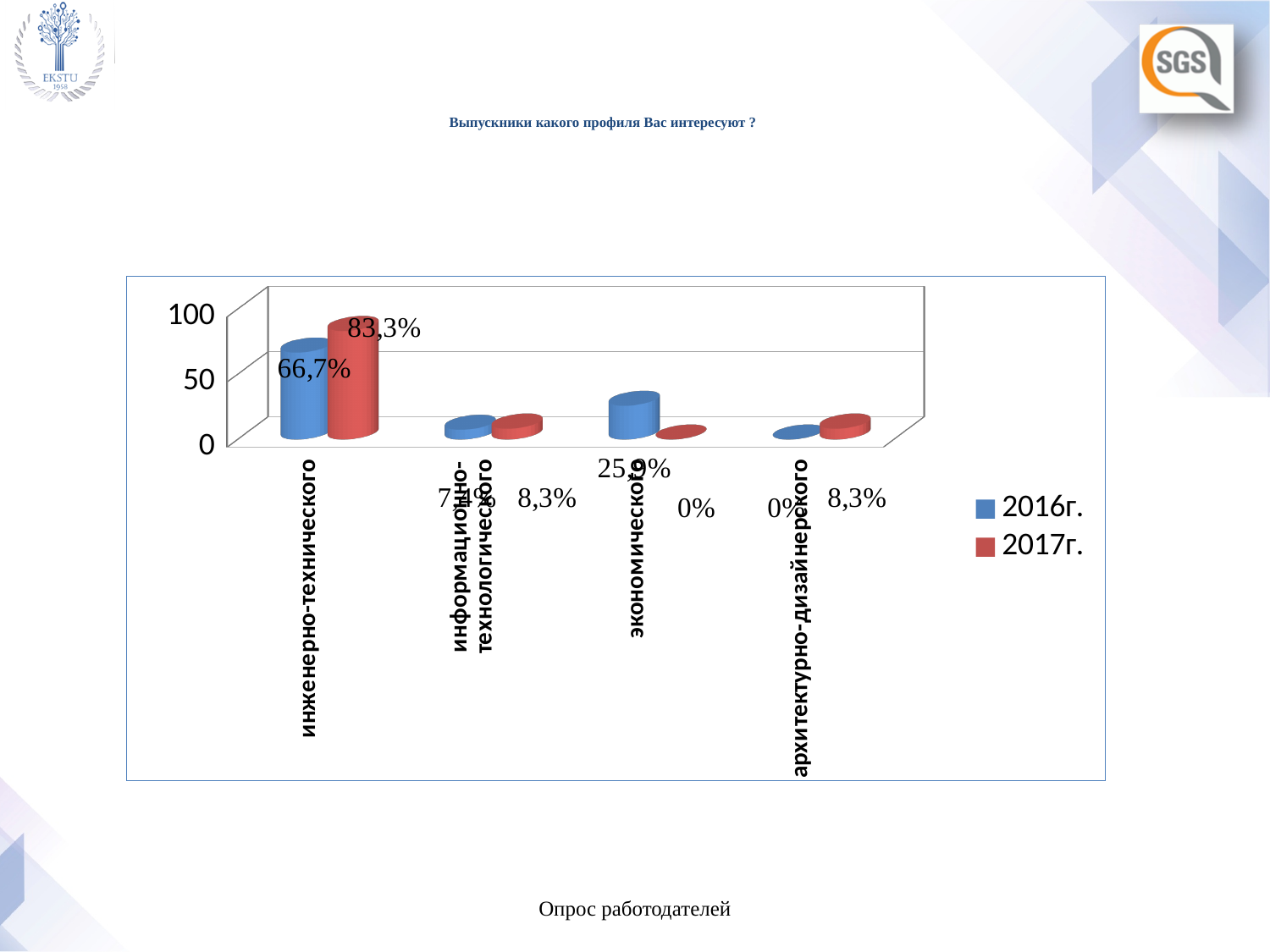
What is the difference between the 2017г. and 2016г. values for инженерно-технического? 16,6% What is the value for архитектурно-дизайнерского in 2017г.? 8,3% What is the value for экономического in 2017г.? 0% Is the 2016г. value for инженерно-технического greater or less than 50? greater What is the value for инженерно-технического in 2017г.? 83,3% Which category has the highest value in 2017г.? инженерно-технического What is the value for инженерно-технического in 2016г.? 66,7% What is the value for архитектурно-дизайнерского in 2016г.? 0% For инженерно-технического, which year has the larger value, 2016г. or 2017г.? 2017г. How many categories are shown on the x axis? 4 How many series does the legend list? 2 What kind of chart is shown on the slide? bar chart